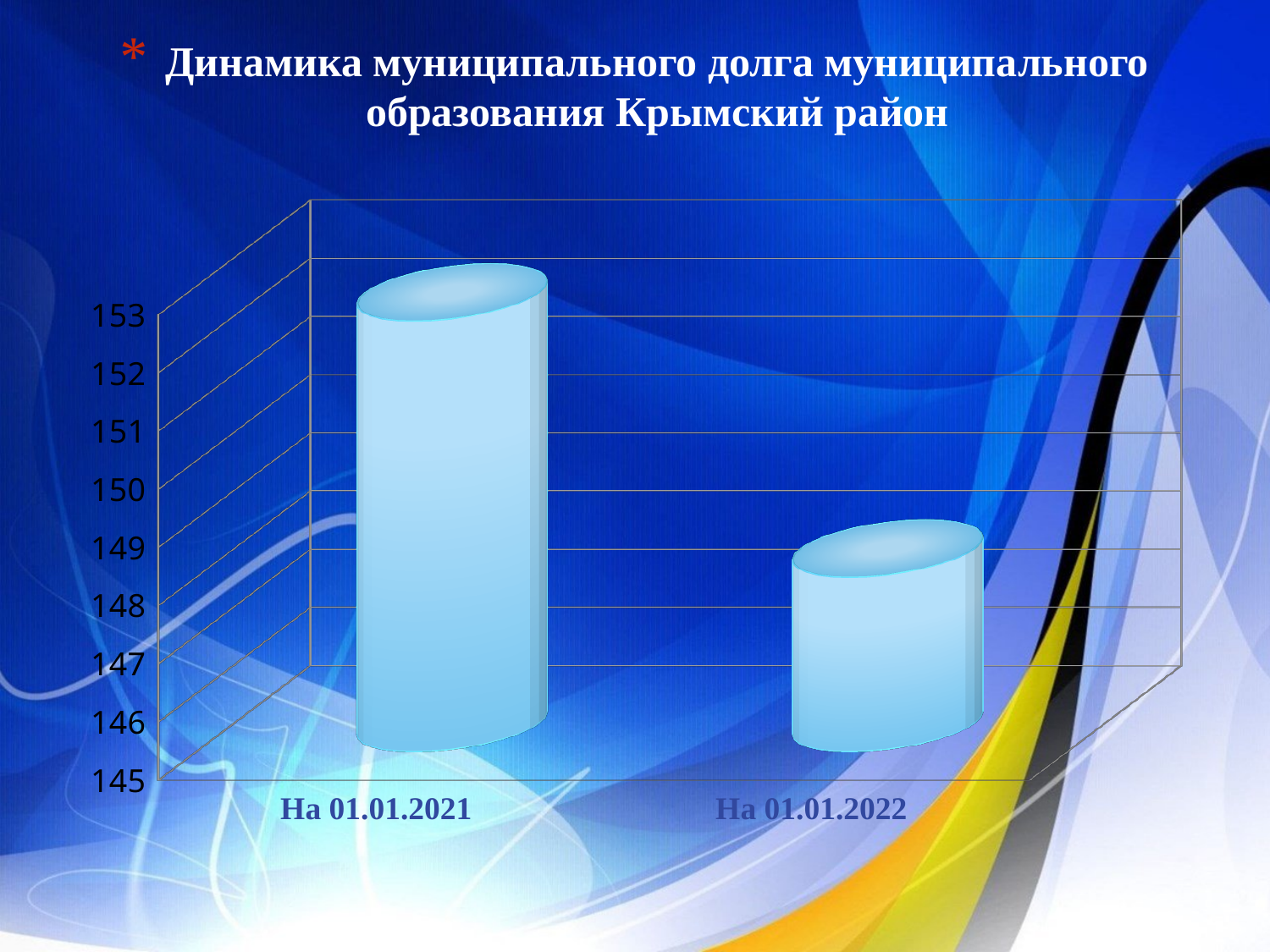
What kind of chart is shown on the slide? bar chart Which is larger, the value for На 01.01.2021 or the value for На 01.01.2022? На 01.01.2021 Which category has the lowest value on the chart? На 01.01.2022 Is the value for На 01.01.2022 greater or less than 150? less Is the value for На 01.01.2022 greater or less than 147? greater Which category has the highest value on the chart? На 01.01.2021 What is the lowest value shown on the vertical axis of the chart? 145 Is the value for На 01.01.2021 greater or less than 150? greater Do the values rise or fall from На 01.01.2021 to На 01.01.2022? fall What is the title of the slide with the chart? Динамика муниципального долга муниципального образования Крымский район How many categories are plotted on the chart? 2